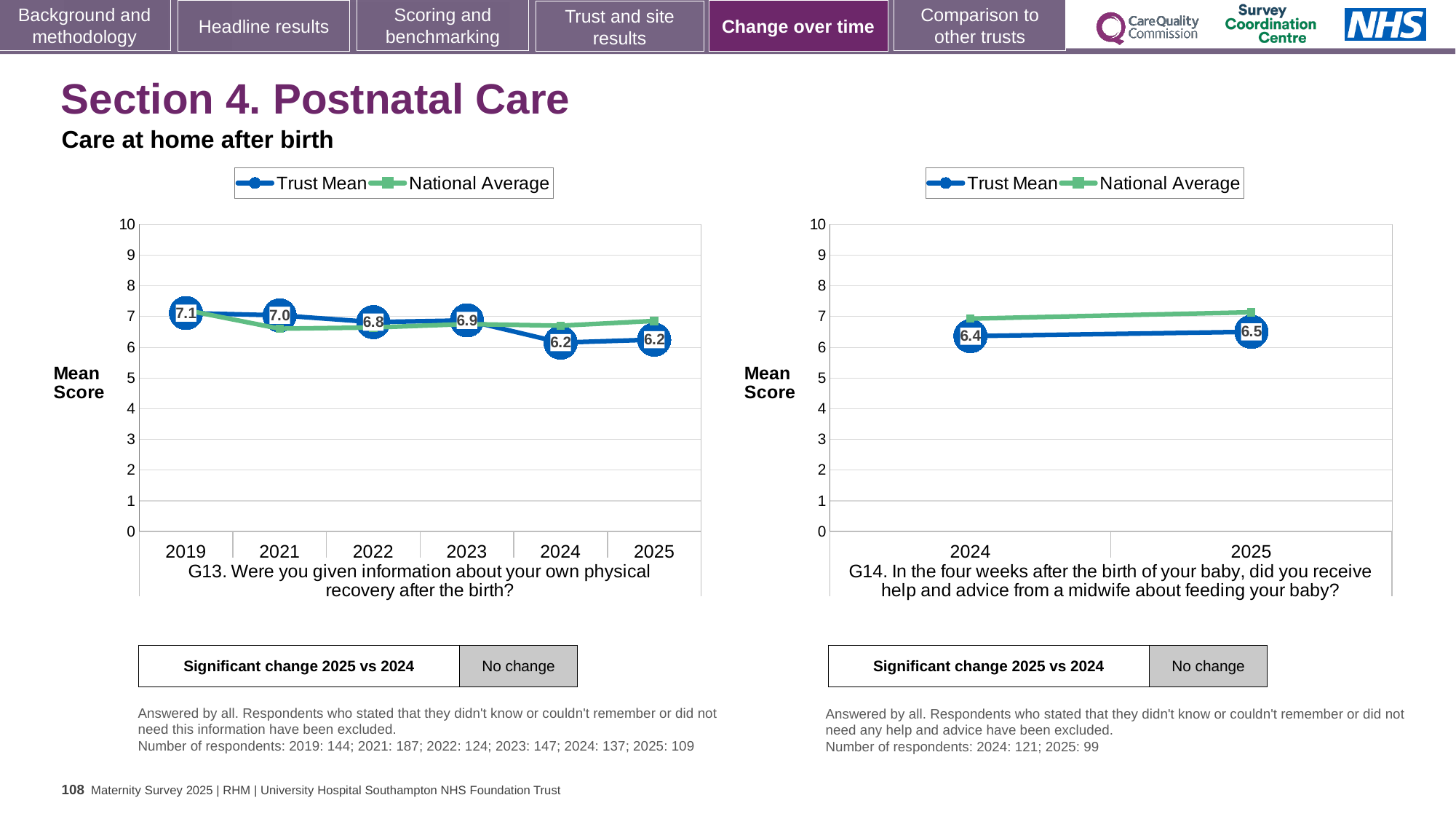
In the G13 chart on the left, what is the Trust Mean score for 2025? 6.2 In the G14 chart on the right, what is the Trust Mean score for 2024? 6.4 How many years are shown on the x axis of the G13 chart on the left? 6 In the G13 chart on the left, which year has the highest Trust Mean score? 2019 In the G13 chart on the left, what is the difference between the Trust Mean scores for 2019 and 2025? 0.9 In the G14 chart on the right, what is the Trust Mean score for 2025? 6.5 In the G13 chart on the left, is the Trust Mean score for 2023 higher or lower than for 2024? higher In the G13 chart on the left, is the National Average value for 2021 greater or less than 7? less What type of chart is the G13 chart on the left? Line chart In the G13 chart on the left, what is the Trust Mean score for 2019? 7.1 How many series does the legend of the G14 chart on the right list? 2 In the G13 chart on the left, does the Trust Mean score generally rise or fall from 2019 to 2025? fall